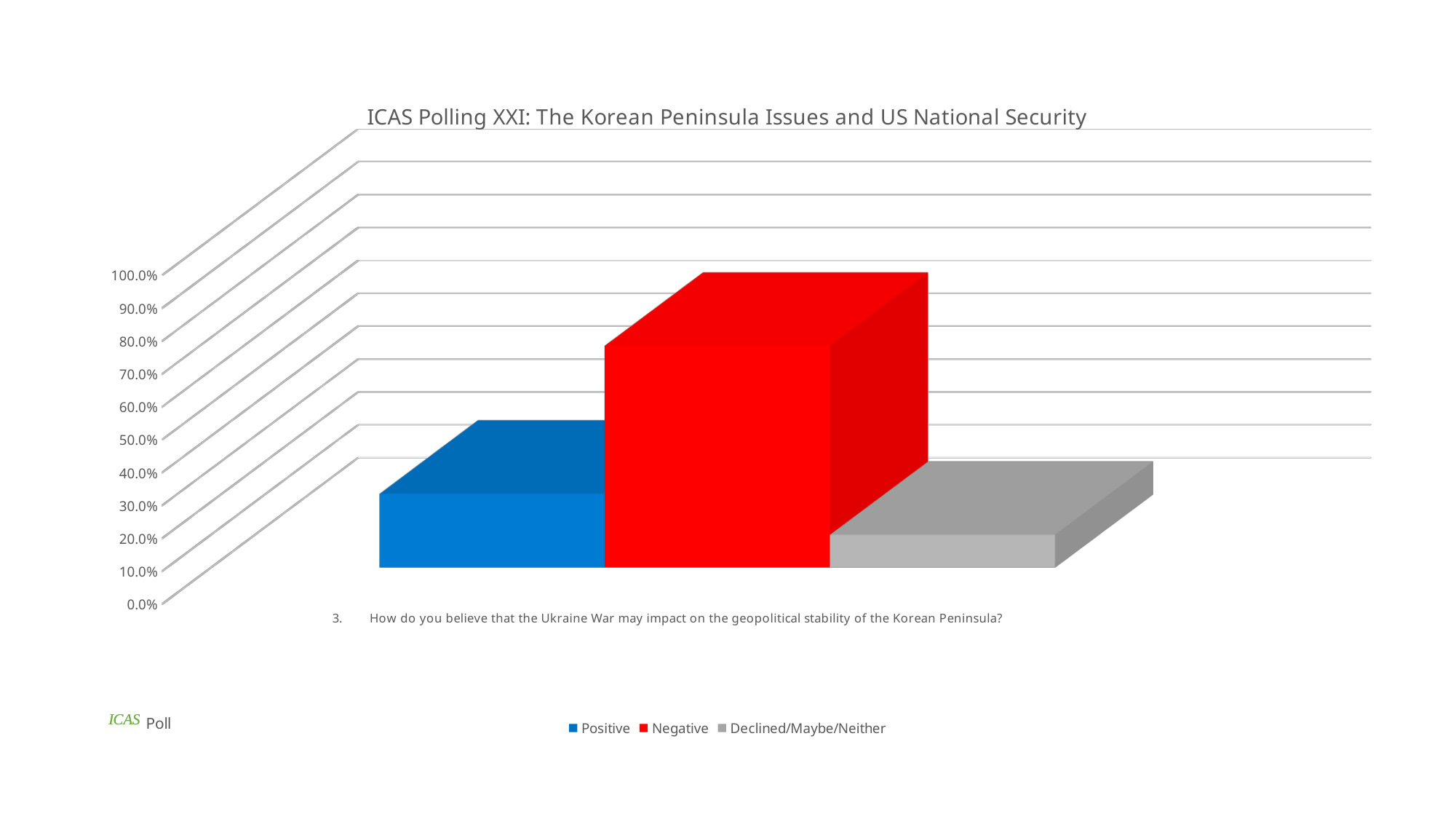
How many series does the legend list? 3 Which response option has the highest value for question 3? Negative Which is larger, the value for Positive or the value for Negative? Negative What is the title of the chart? ICAS Polling XXI: The Korean Peninsula Issues and US National Security Which is larger, the value for Positive or the value for Declined/Maybe/Neither? Positive Which colour represents the Negative series in the legend? Red Is the value for Negative greater or less than 50.0%? greater Is the value for Declined/Maybe/Neither greater or less than 30.0%? less How many survey questions (categories) are plotted on the x axis? 1 Is the value for Positive greater or less than 40.0%? less What kind of chart is shown on the slide? Bar chart Which response option has the lowest value for question 3? Declined/Maybe/Neither